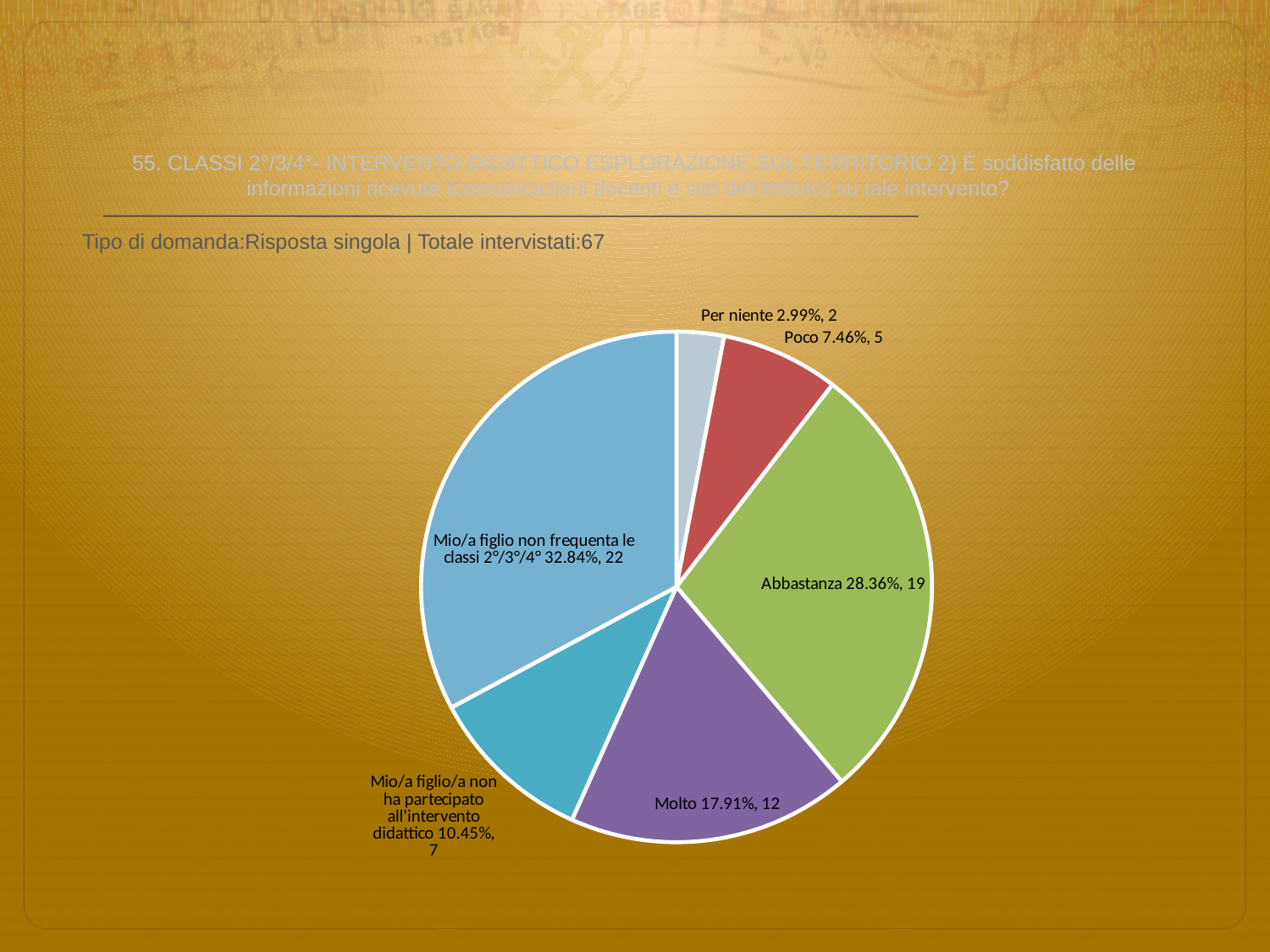
What is the count for the "Poco" slice? 5 What percentage share does the "Molto" slice have? 17.91% What is the total number of respondents (Totale intervistati) stated on the slide? 67 What kind of chart is shown on the slide? pie chart Which category has the largest slice of the pie? Mio/a figlio non frequenta le classi 2°/3°/4° What is the count for the "Abbastanza" slice? 19 Which category has the smallest slice of the pie? Per niente How many slices does the pie chart have? 6 What is the count for the "Mio/a figlio non frequenta le classi 2°/3°/4°" slice? 22 What percentage share does the "Per niente" slice have? 2.99% Which is larger, the "Poco" slice or the "Mio/a figlio/a non ha partecipato all'intervento didattico" slice? Mio/a figlio/a non ha partecipato all'intervento didattico What is the difference in count between "Abbastanza" and "Molto"? 7